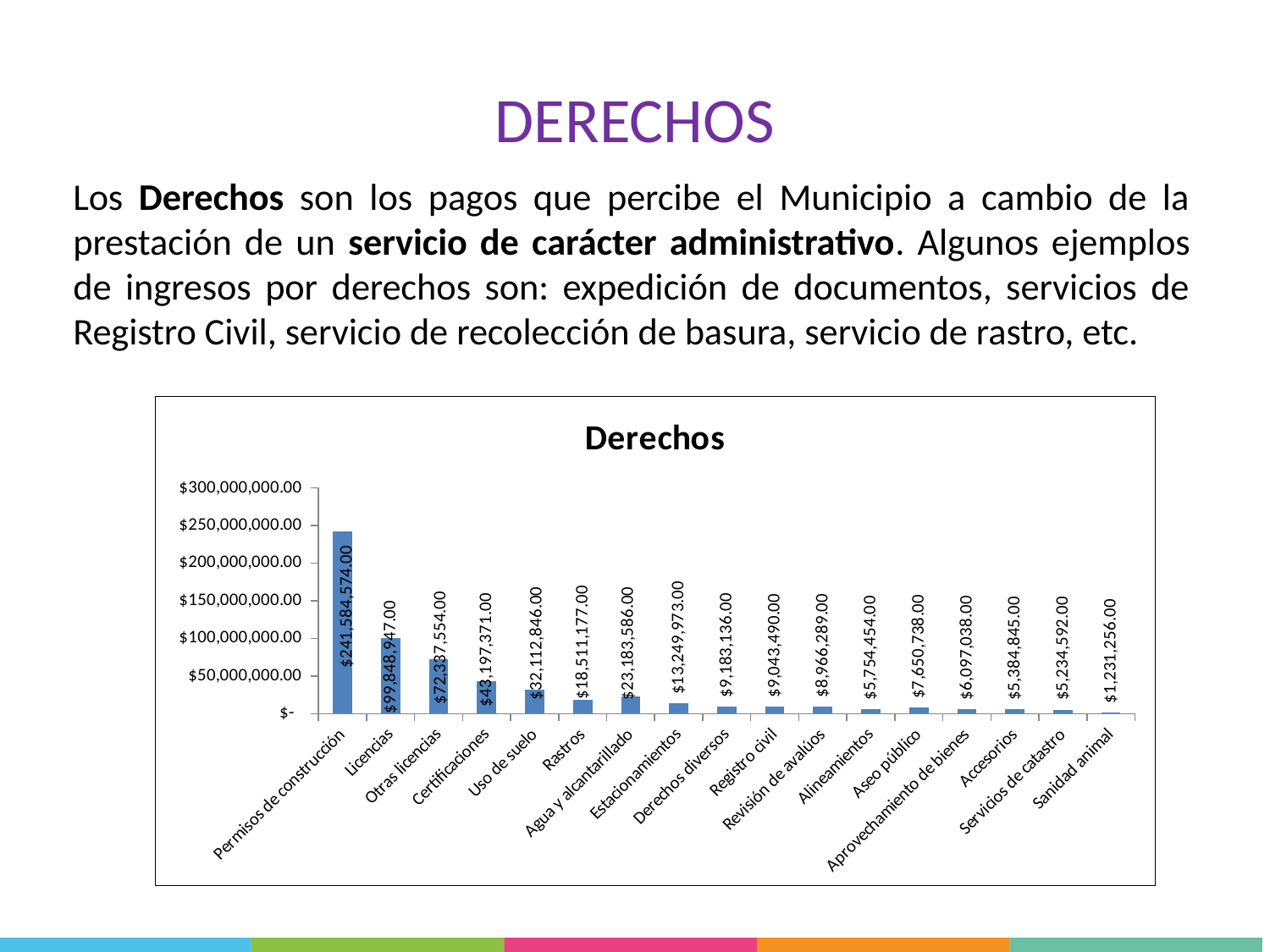
What type of chart is shown on the slide? Bar chart Which is larger, the value for Uso de suelo or the value for Estacionamientos? Uso de suelo What is the value for Sanidad animal? $1,231,256.00 Which category has the highest value? Permisos de construcción Which category has the lowest value? Sanidad animal How many categories are plotted in the chart? 17 What is the value for Uso de suelo? $32,112,846.00 What is the value for Estacionamientos? $13,249,973.00 Is the value for Licencias greater or less than $150,000,000.00? less What is the value for Permisos de construcción? $241,584,574.00 What is the difference between the values for Agua y alcantarillado and Rastros? $4,672,409.00 What is the title of the chart? Derechos